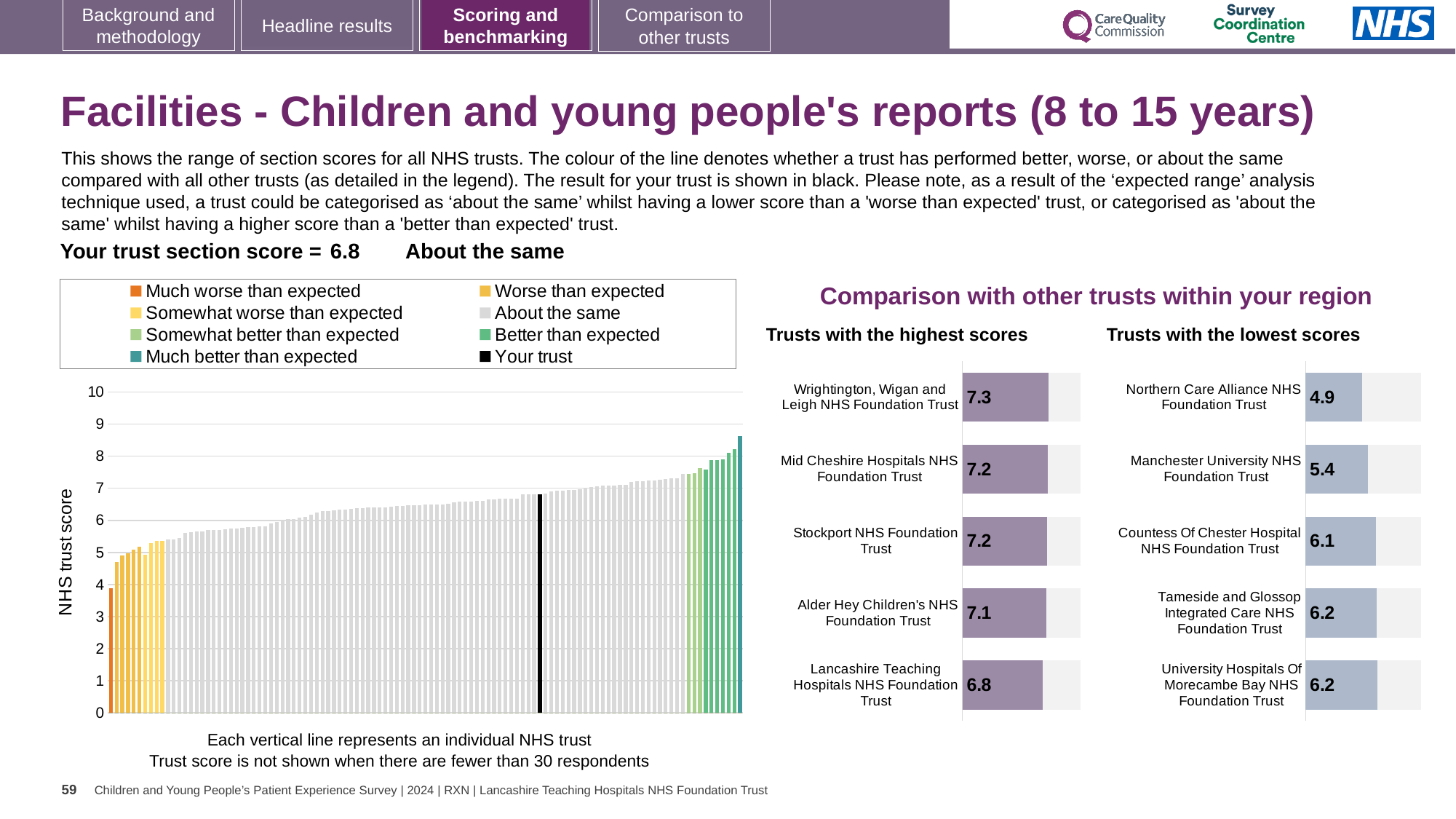
In the 'Trusts with the lowest scores' chart, which trust has the lowest score? Northern Care Alliance NHS Foundation Trust In the 'Trusts with the lowest scores' chart, what is the score for Northern Care Alliance NHS Foundation Trust? 4.9 How many trusts are listed in the 'Trusts with the lowest scores' chart? 5 In the 'Trusts with the highest scores' chart, what is the difference between the scores of Wrightington, Wigan and Leigh NHS Foundation Trust and Lancashire Teaching Hospitals NHS Foundation Trust? 0.5 In the 'Trusts with the lowest scores' chart, what is the difference between the scores of Manchester University NHS Foundation Trust and Northern Care Alliance NHS Foundation Trust? 0.5 How many entries does the legend of the 'NHS trust score' chart on the left list? 8 In the 'Trusts with the lowest scores' chart, which has the higher score: Manchester University NHS Foundation Trust or Countess Of Chester Hospital NHS Foundation Trust? Countess Of Chester Hospital NHS Foundation Trust In the 'Trusts with the highest scores' chart, what is the score for Alder Hey Children's NHS Foundation Trust? 7.1 In the 'Trusts with the highest scores' chart, what is the score for Wrightington, Wigan and Leigh NHS Foundation Trust? 7.3 In the 'NHS trust score' chart on the left, do the bar values rise or fall from left to right? Rise In the 'Trusts with the highest scores' chart, which trust has the lowest score? Lancashire Teaching Hospitals NHS Foundation Trust What kind of chart is the 'NHS trust score' chart on the left of the slide? Bar chart